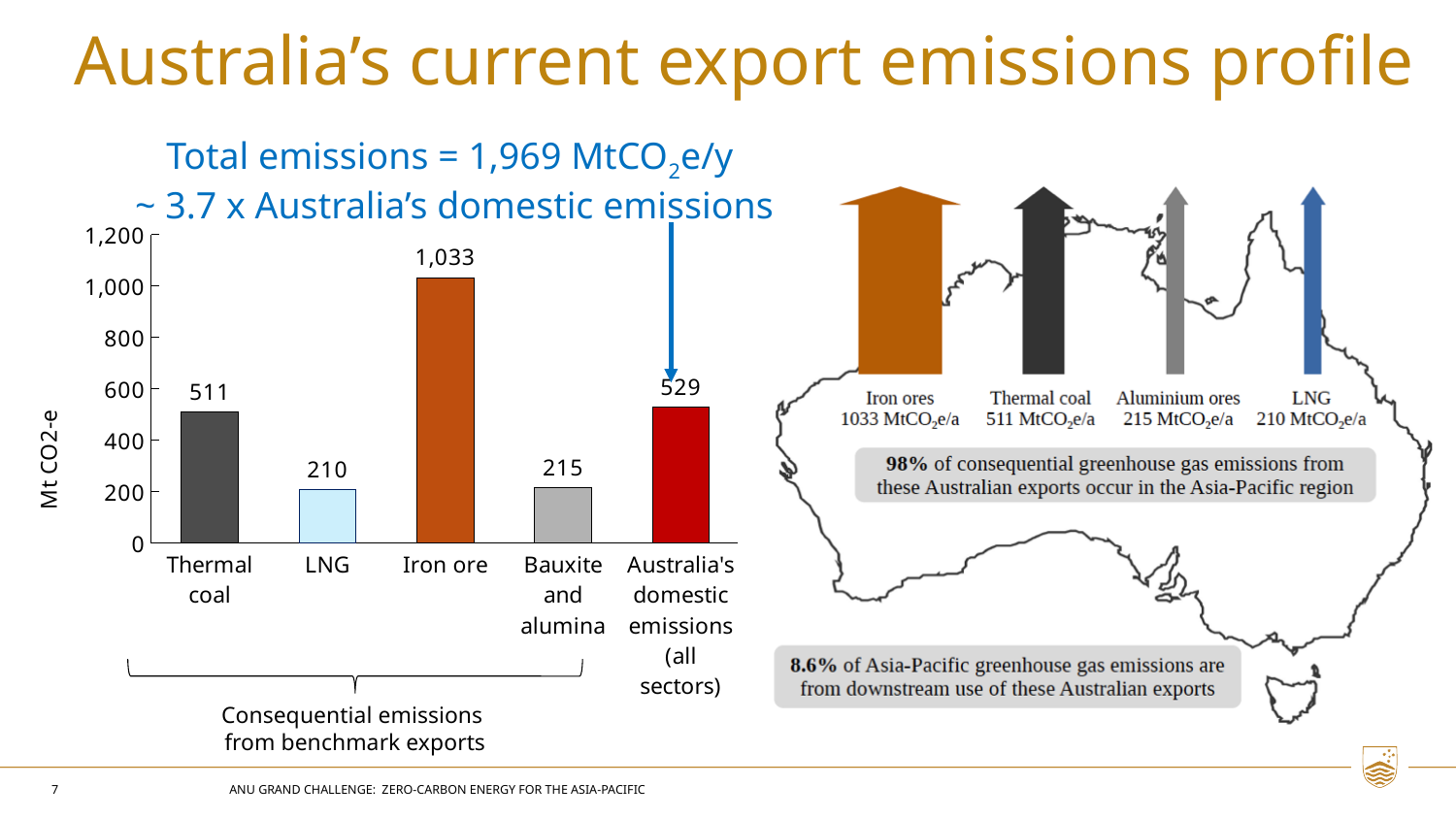
Which is larger in the bar chart: Thermal coal or Australia's domestic emissions (all sectors)? Australia's domestic emissions (all sectors) How many categories are shown in the bar chart? 5 What is the difference between the Iron ore value and the Thermal coal value in the bar chart? 522 What is the value for Thermal coal in the bar chart? 511 What is the value for Australia's domestic emissions (all sectors) in the bar chart? 529 Which category has the highest value in the bar chart? Iron ore What is the label of the vertical axis of the bar chart? Mt CO2-e What is the value for Iron ore in the bar chart? 1,033 What is the value for LNG in the bar chart? 210 What type of chart is shown on the left of the slide? Bar chart Which category has the lowest value in the bar chart? LNG Is the value for Bauxite and alumina greater or less than 400 in the bar chart? less